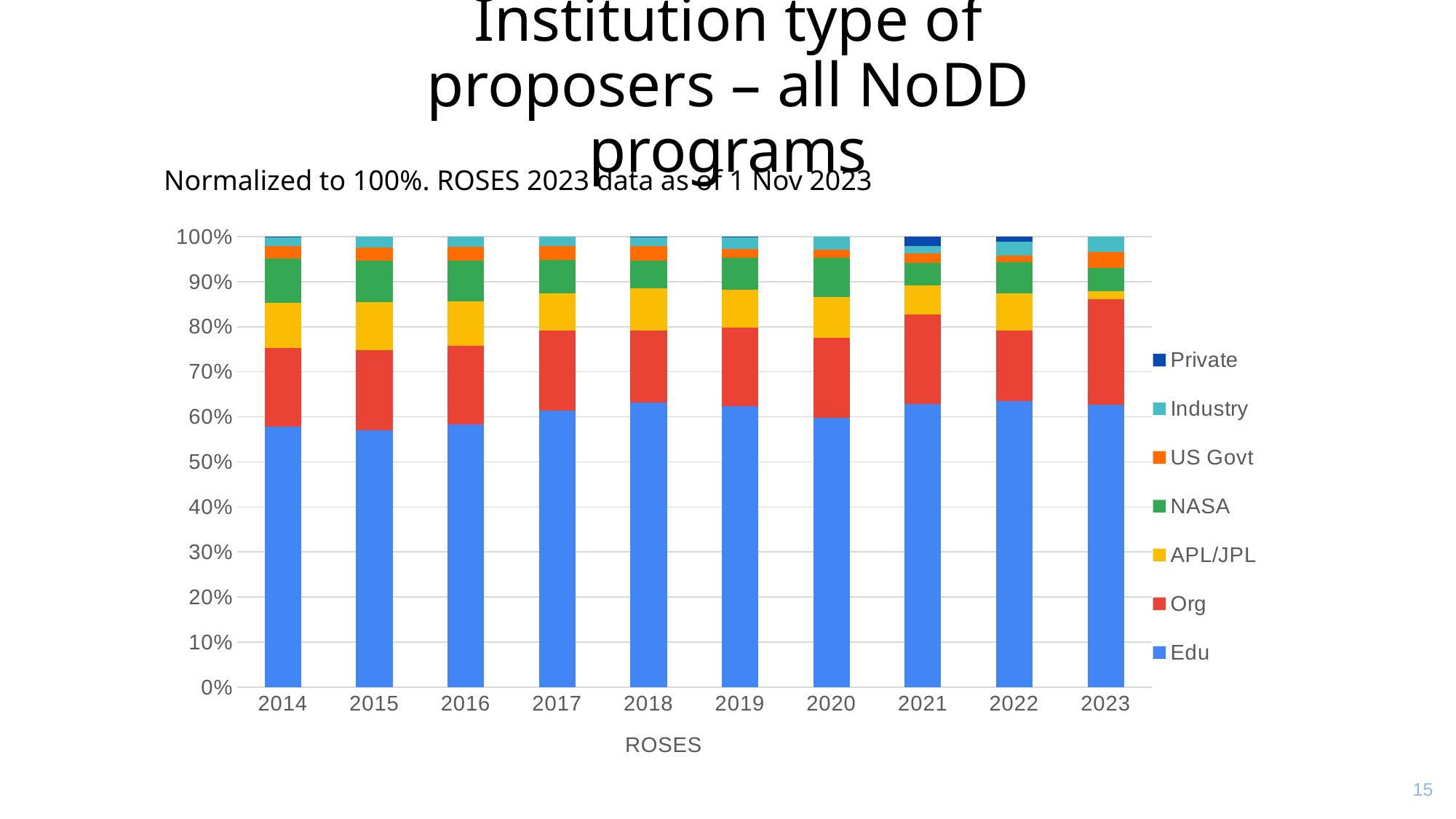
Is the Edu share in 2022 greater or less than 60%? greater What kind of chart is shown on the slide? Stacked bar chart How many series does the legend list? 7 What is the title of the x axis? ROSES Is the Edu share in 2014 greater or less than 60%? less Which year has the larger Edu share, 2015 or 2022? 2022 Which series is listed at the bottom of the legend? Edu What is the total height of the 2014 stacked bar? 100% How many years (categories) are shown on the x axis? 10 Is the Edu share in 2018 greater or less than 60%? greater Which year has the larger Org share, 2014 or 2023? 2023